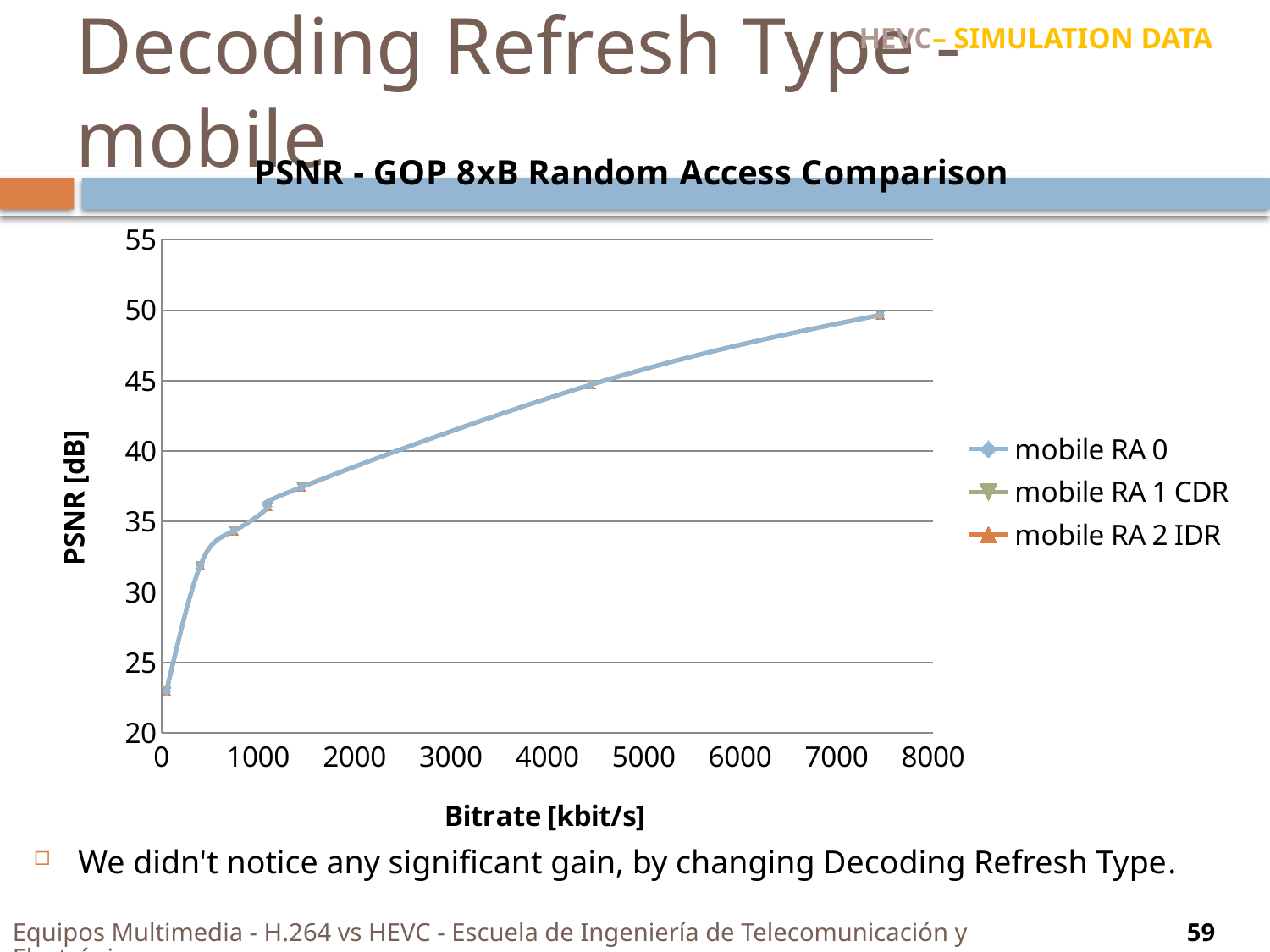
Is the PSNR value for mobile RA 0 at about 400 kbit/s greater or less than 35? less What is the label of the y axis? PSNR [dB] What kind of chart is shown on the slide? line chart What is the maximum value shown on the x axis? 8000 Is the PSNR value for mobile RA 0 at the lowest bitrate (near 0 kbit/s) greater or less than 25? less Is the PSNR value for mobile RA 1 CDR at about 1500 kbit/s greater or less than 40? less What is the title of the chart? PSNR - GOP 8xB Random Access Comparison Which series has the highest PSNR at the highest bitrate, or are the three series indistinguishable? indistinguishable (they overlap) Does PSNR rise or fall as bitrate increases along the x axis? rise How many series does the legend list? 3